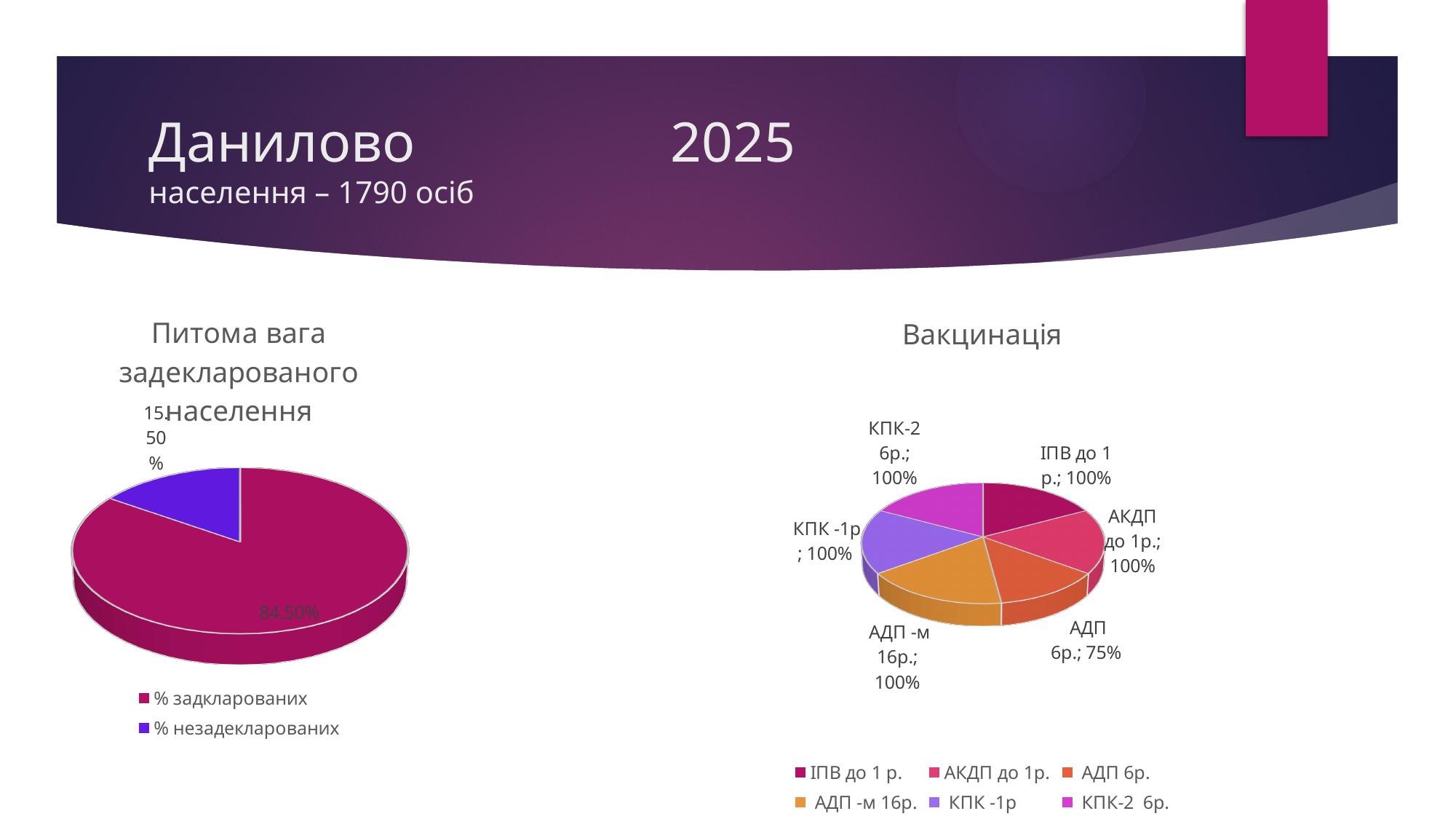
In the "Вакцинація" chart, how many categories are shown? 6 In the "Питома вага задекларованого населення" chart, what is the value for "% задкларованих"? 84.50% In the "Вакцинація" chart, what is the value for "ІПВ до 1 р."? 100% In the "Вакцинація" chart, what is the value for "АДП 6р."? 75% In the "Вакцинація" chart, what is the difference between the values for "АКДП до 1р." and "АДП 6р."? 25% In the "Питома вага задекларованого населення" chart, which category has the largest slice? % задкларованих In the "Питома вага задекларованого населення" chart, what is the value for "% незадекларованих"? 15.50% How many entries does the legend of the "Питома вага задекларованого населення" chart list? 2 In the "Вакцинація" chart, which category has the lowest value? АДП 6р. What is the title of the chart on the right side of the slide? Вакцинація In the "Вакцинація" chart, what is the value for "КПК-2 6р."? 100% What kind of chart is the "Питома вага задекларованого населення" chart on the left? pie chart